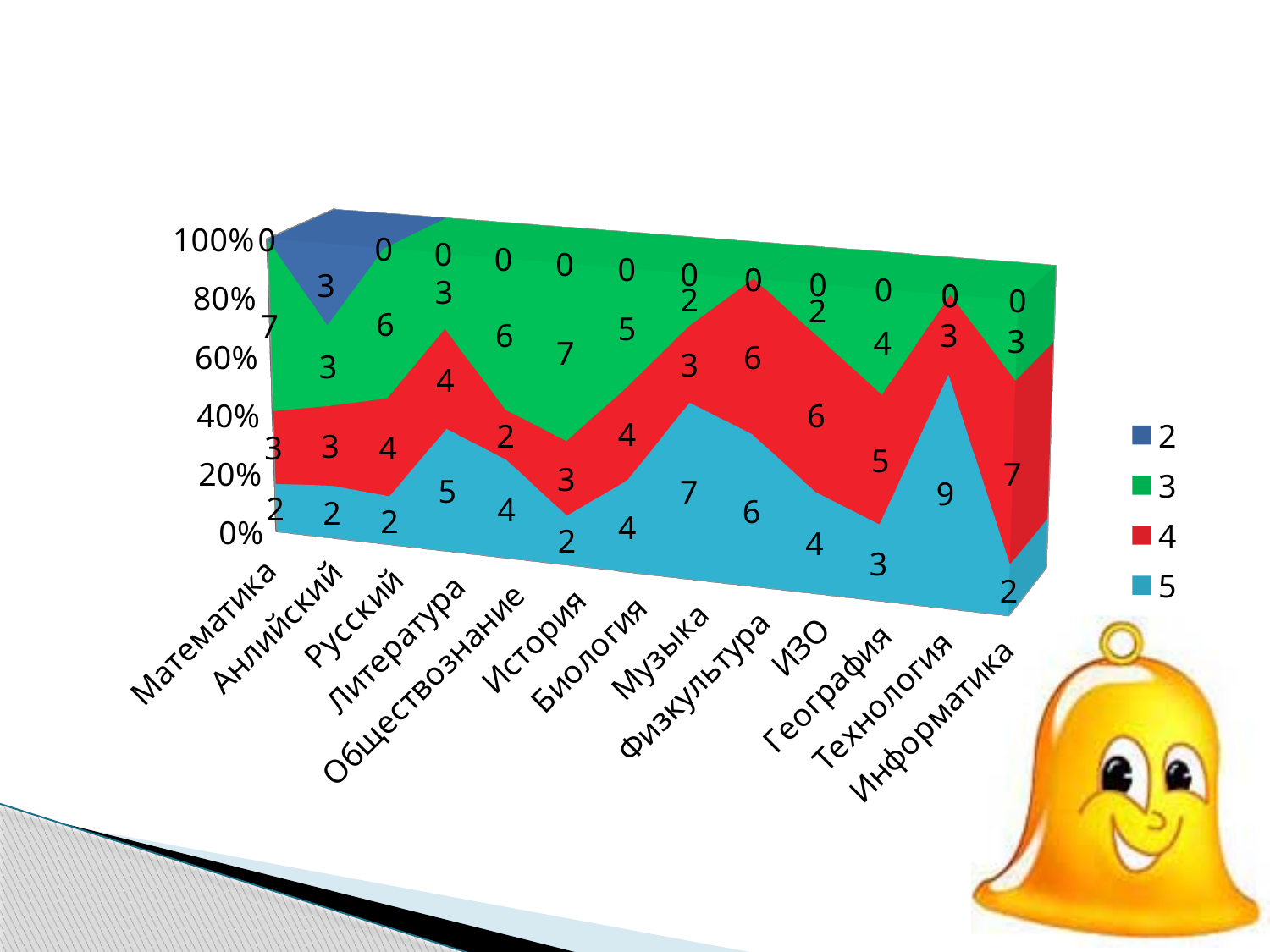
What is the value of series 2 for Анлийский? 3 What is the value of series 4 for Информатика? 7 What is the difference between the series 5 values for Технология and Музыка? 2 How many series does the legend list? 4 What is the total of the data labels for Технология? 12 What are the entries listed in the legend? 2, 3, 4, 5 Which is larger: the series 4 value for Информатика or the series 4 value for Математика? Информатика What type of chart is shown on the slide? area chart Which category has the highest value for series 5? Технология What is the value of series 5 for Технология? 9 How many categories are shown along the x axis? 13 What is the value of series 3 for Математика? 7